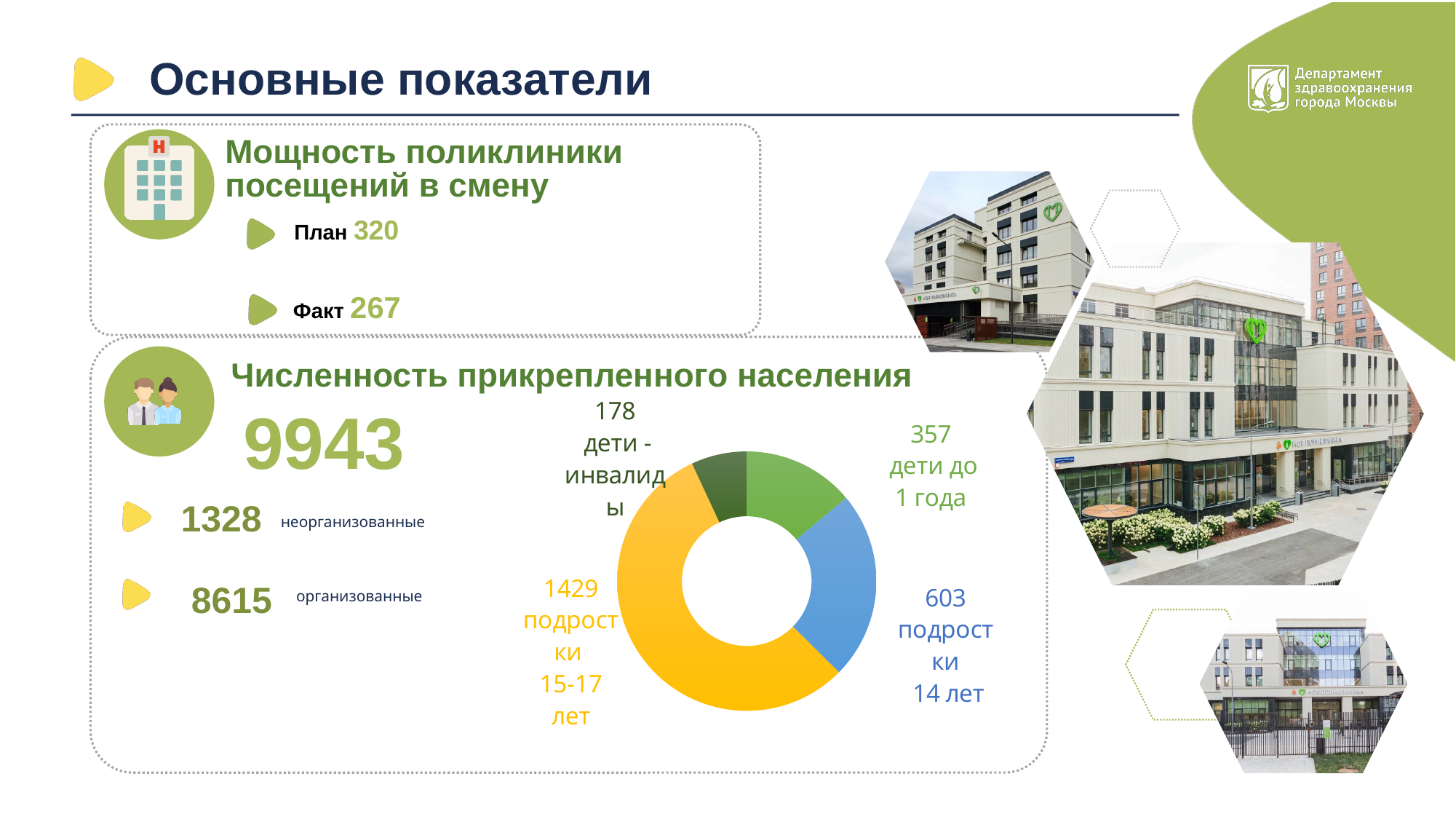
What is the value for "дети-инвалиды" in the donut chart? 178 What is the value for "дети до 1 года" in the donut chart? 357 What is the value for "подростки 14 лет" in the donut chart? 603 What is the difference between the values for "подростки 15-17 лет" and "подростки 14 лет"? 826 What is the total of all four values shown in the donut chart? 2567 Which category has the smallest slice in the donut chart? дети-инвалиды Which is larger in the donut chart: "дети до 1 года" or "дети-инвалиды"? дети до 1 года What colour is the slice for "подростки 14 лет" in the donut chart? Blue How many slices does the donut chart have? 4 What is the value for "подростки 15-17 лет" in the donut chart? 1429 Which category has the largest slice in the donut chart? подростки 15-17 лет What kind of chart is shown on the slide? Donut (pie) chart